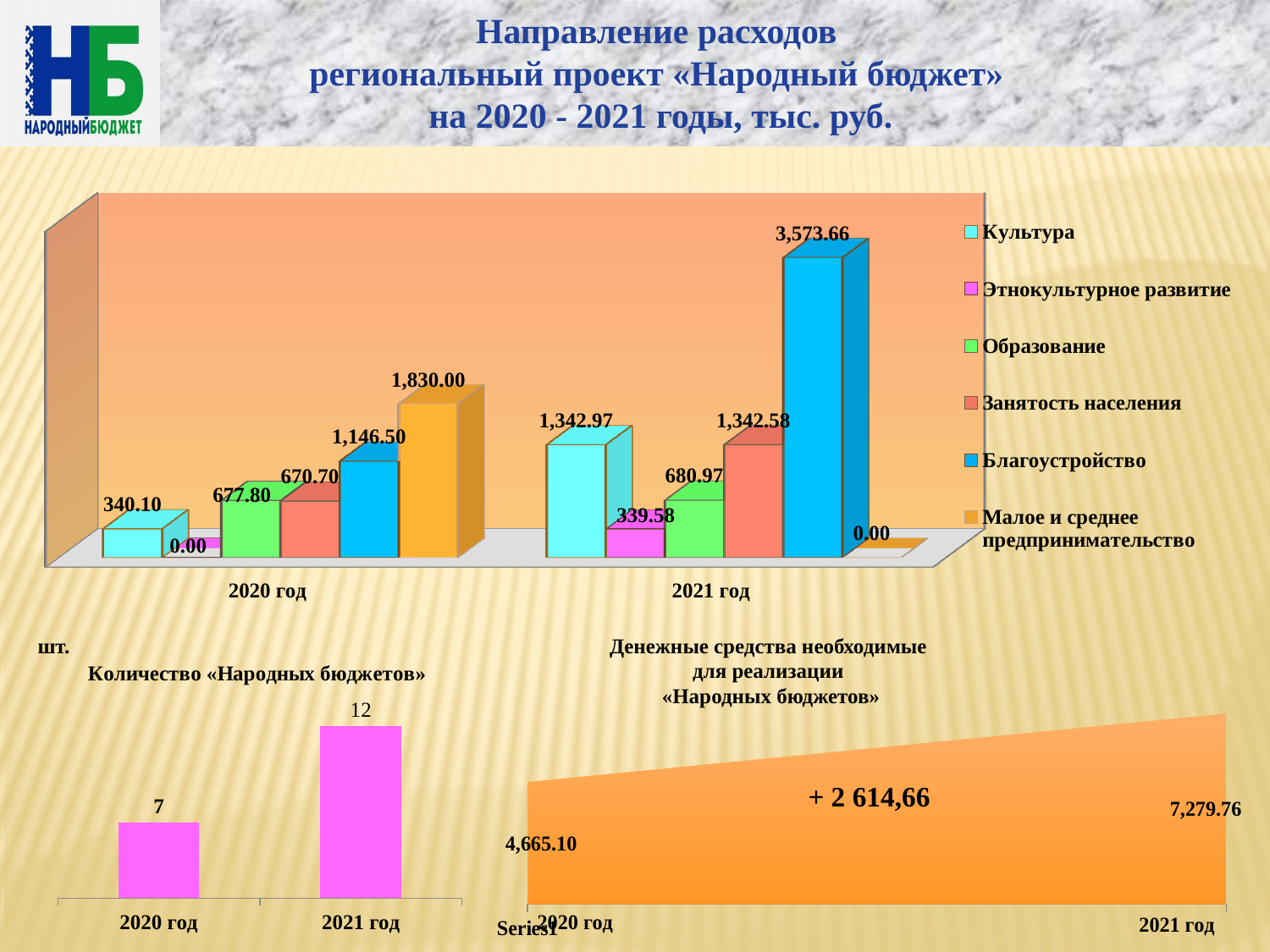
In the top chart (Направление расходов), which series has the lowest value in 2020 год? Этнокультурное развитие In the bottom-left chart (Количество «Народных бюджетов»), what is the value for 2021 год? 12 In the top chart (Направление расходов), which is larger: Культура in 2021 год or Благоустройство in 2020 год? Культура in 2021 год How many series does the legend of the top chart (Направление расходов) list? 6 In the top chart (Направление расходов), what is the value for Культура in 2020 год? 340.10 In the top chart (Направление расходов), what is the difference between the Благоустройство values for 2021 год and 2020 год? 2,427.16 In the top chart (Направление расходов), what is the value for Малое и среднее предпринимательство in 2020 год? 1,830.00 In the bottom-left chart (Количество «Народных бюджетов»), what is the difference between 2021 год and 2020 год? 5 In the top chart (Направление расходов), which series has the highest value in 2021 год? Благоустройство What kind of chart is the top chart (Направление расходов)? Bar chart In the bottom-right chart (Денежные средства необходимые для реализации «Народных бюджетов»), what is the value for 2020 год? 4,665.10 In the top chart (Направление расходов), what is the value for Благоустройство in 2021 год? 3,573.66